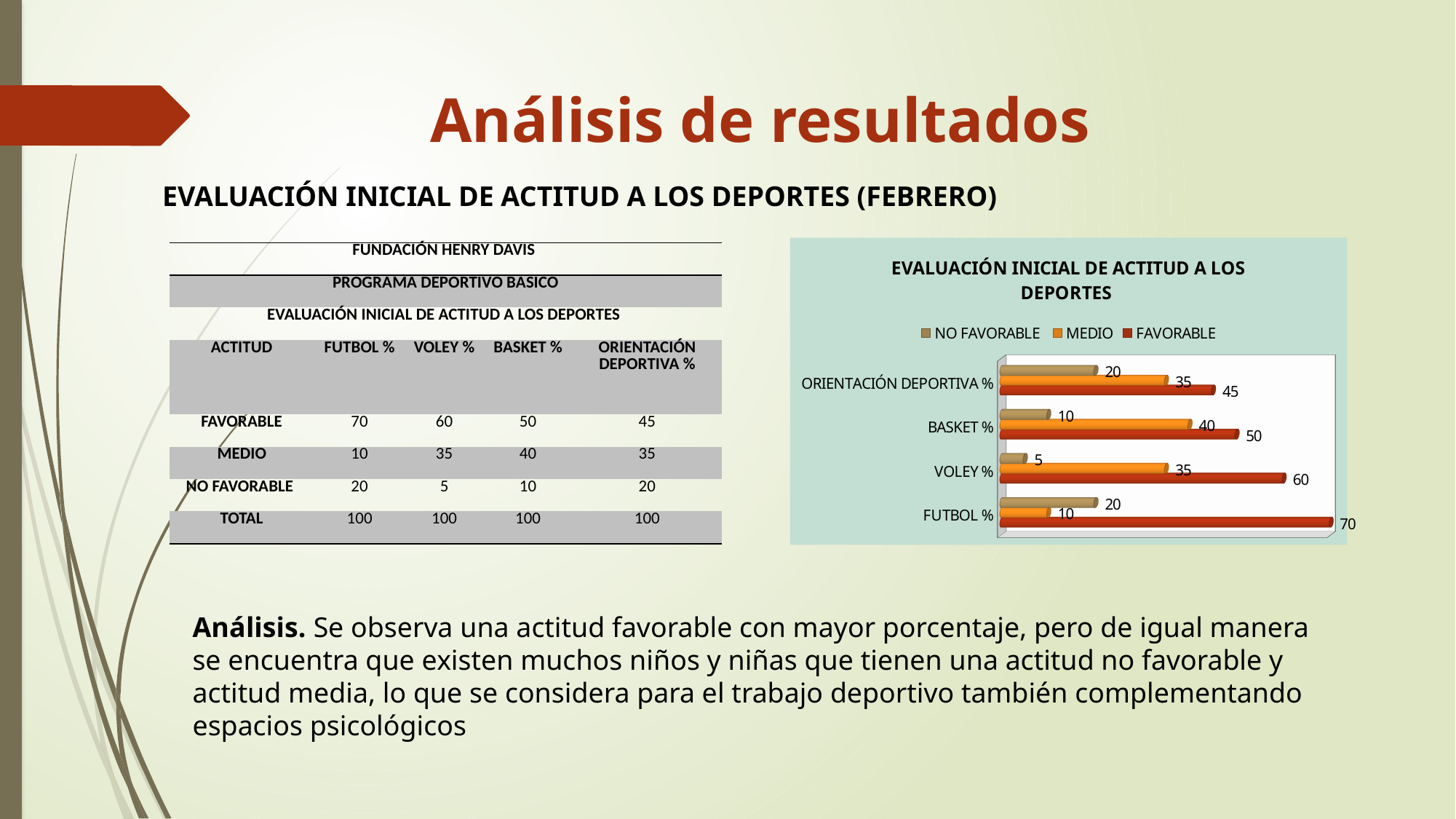
What is the difference between the FAVORABLE values for FUTBOL % and VOLEY % in the chart? 10 What kind of chart is shown on the slide? Bar chart What is the MEDIO value for BASKET % in the chart? 40 What is the FAVORABLE value for FUTBOL % in the chart? 70 Which category has the lowest NO FAVORABLE value in the chart? VOLEY % How many series does the chart's legend list? 3 What is the title of the chart on the slide? EVALUACIÓN INICIAL DE ACTITUD A LOS DEPORTES Which is larger in the chart: the MEDIO value for VOLEY % or the MEDIO value for BASKET %? BASKET % What is the FAVORABLE value for ORIENTACIÓN DEPORTIVA % in the chart? 45 Which category has the highest FAVORABLE value in the chart? FUTBOL % What is the NO FAVORABLE value for VOLEY % in the chart? 5 How many categories are shown on the chart's vertical axis? 4